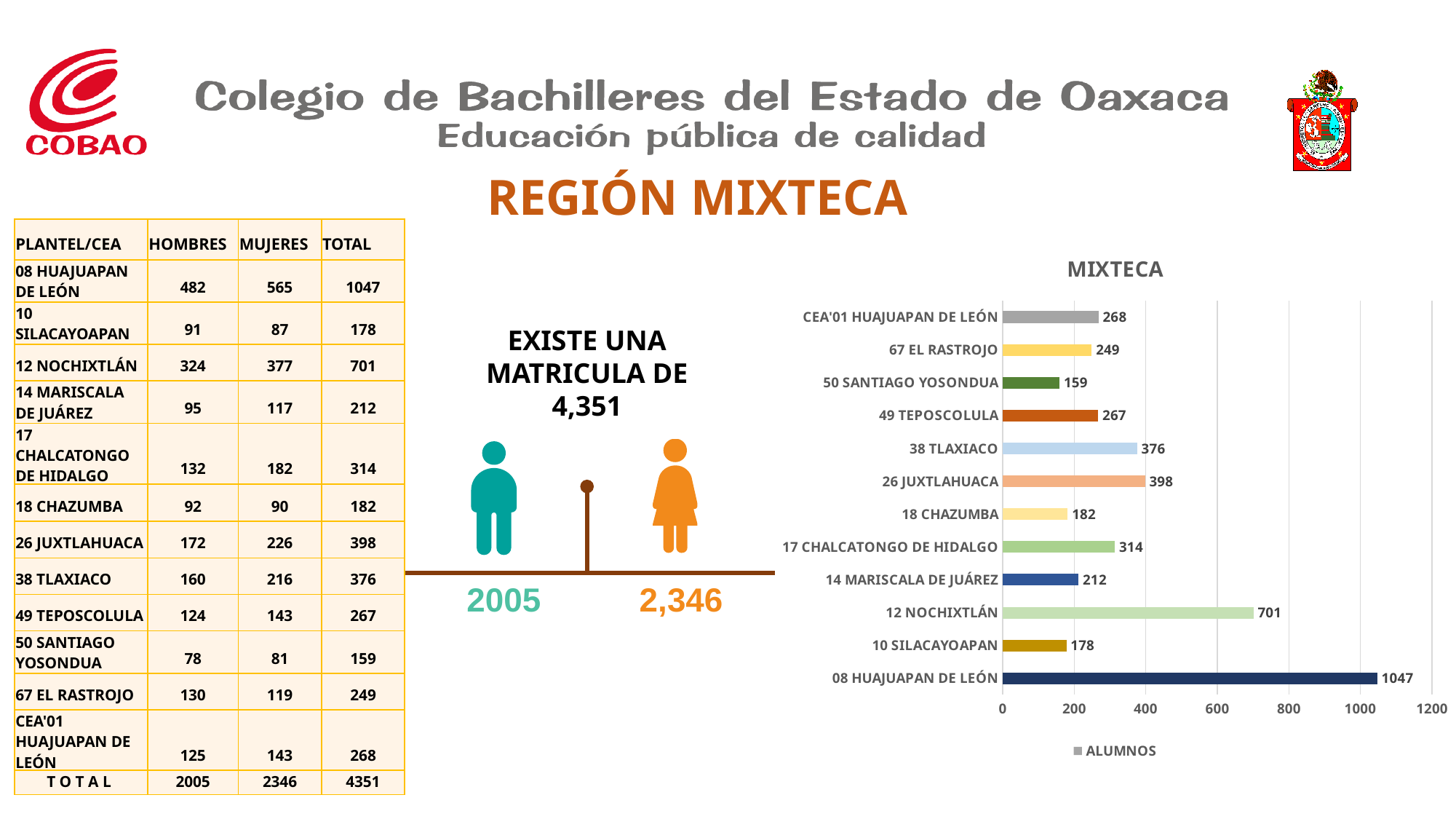
How many series does the legend of the MIXTECA chart list? 1 What is the value for 49 TEPOSCOLULA in the MIXTECA chart? 267 How many categories are shown in the MIXTECA chart? 12 Which is larger in the MIXTECA chart, 17 CHALCATONGO DE HIDALGO or 14 MARISCALA DE JUÁREZ? 17 CHALCATONGO DE HIDALGO What kind of chart is the MIXTECA chart? bar chart What is the difference between the values for 12 NOCHIXTLÁN and 26 JUXTLAHUACA in the MIXTECA chart? 303 What is the value for CEA'01 HUAJUAPAN DE LEÓN in the MIXTECA chart? 268 What is the value for 38 TLAXIACO in the MIXTECA chart? 376 Which category has the lowest value in the MIXTECA chart? 50 SANTIAGO YOSONDUA What is the legend entry of the MIXTECA chart? ALUMNOS Which category has the highest value in the MIXTECA chart? 08 HUAJUAPAN DE LEÓN Is the value for 18 CHAZUMBA in the MIXTECA chart greater or less than 200? less